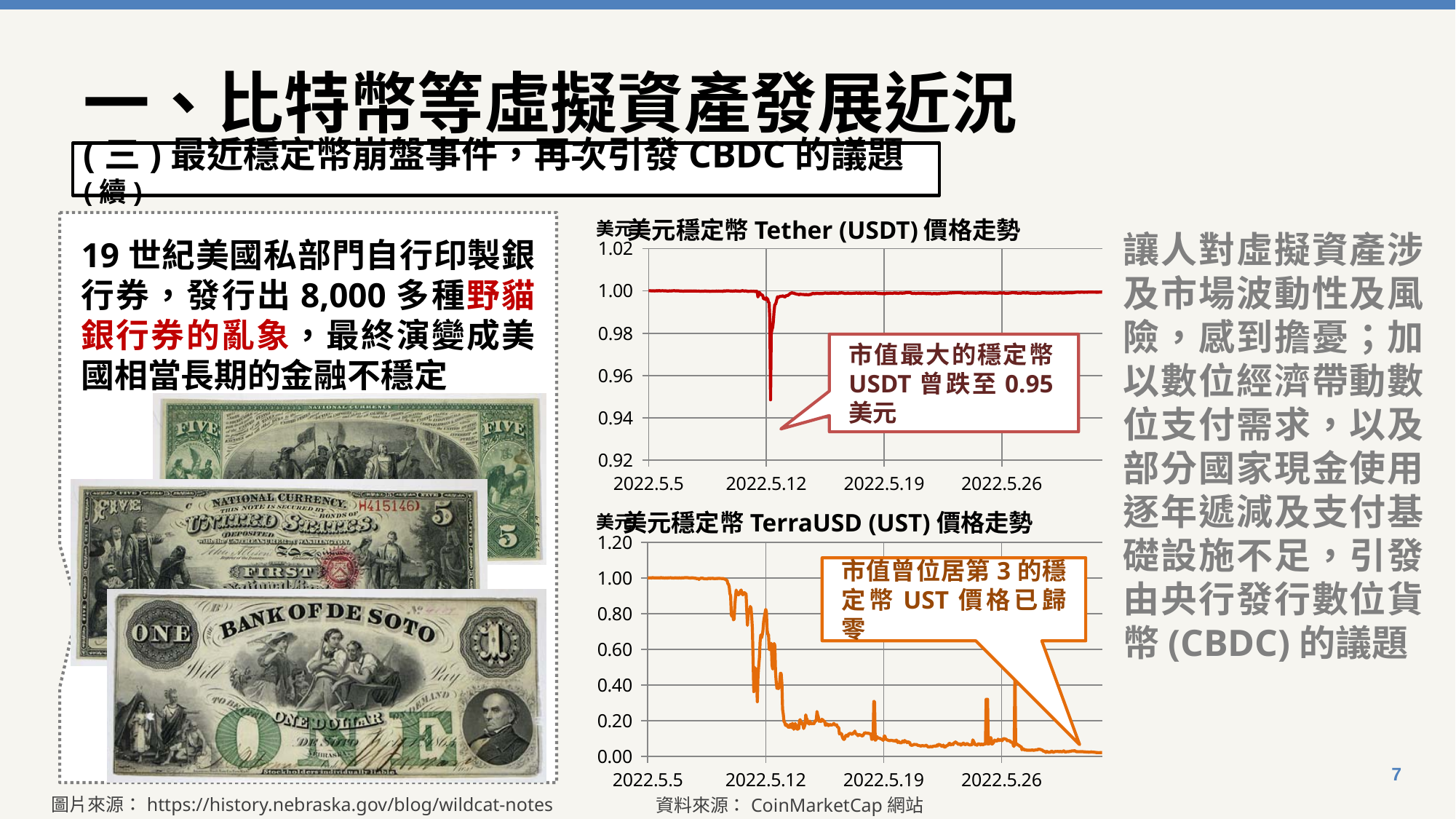
In the 美元穩定幣 TerraUSD (UST) 價格走勢 chart, is the value at 2022.5.26 greater or less than 0.20? less In the 美元穩定幣 Tether (USDT) 價格走勢 chart, is the value at 2022.5.5 greater or less than 0.98? greater What kind of chart is the 美元穩定幣 TerraUSD (UST) 價格走勢 chart? line chart In the 美元穩定幣 TerraUSD (UST) 價格走勢 chart, is the value at 2022.5.5 greater or less than 0.80? greater How many date labels are shown on the x axis of the 美元穩定幣 TerraUSD (UST) 價格走勢 chart? 4 In the 美元穩定幣 Tether (USDT) 價格走勢 chart, what is the lowest price USDT fell to, according to the callout? 0.95 美元 What is the title of the top chart on the slide? 美元穩定幣 Tether (USDT) 價格走勢 What is the data source given for the two price charts? CoinMarketCap 網站 What kind of chart is the 美元穩定幣 Tether (USDT) 價格走勢 chart? line chart Comparing the two charts, which stablecoin's price fell further by the end of May 2022, USDT or UST? UST In the 美元穩定幣 TerraUSD (UST) 價格走勢 chart, does the price rise or fall from 2022.5.5 to 2022.5.26? fall